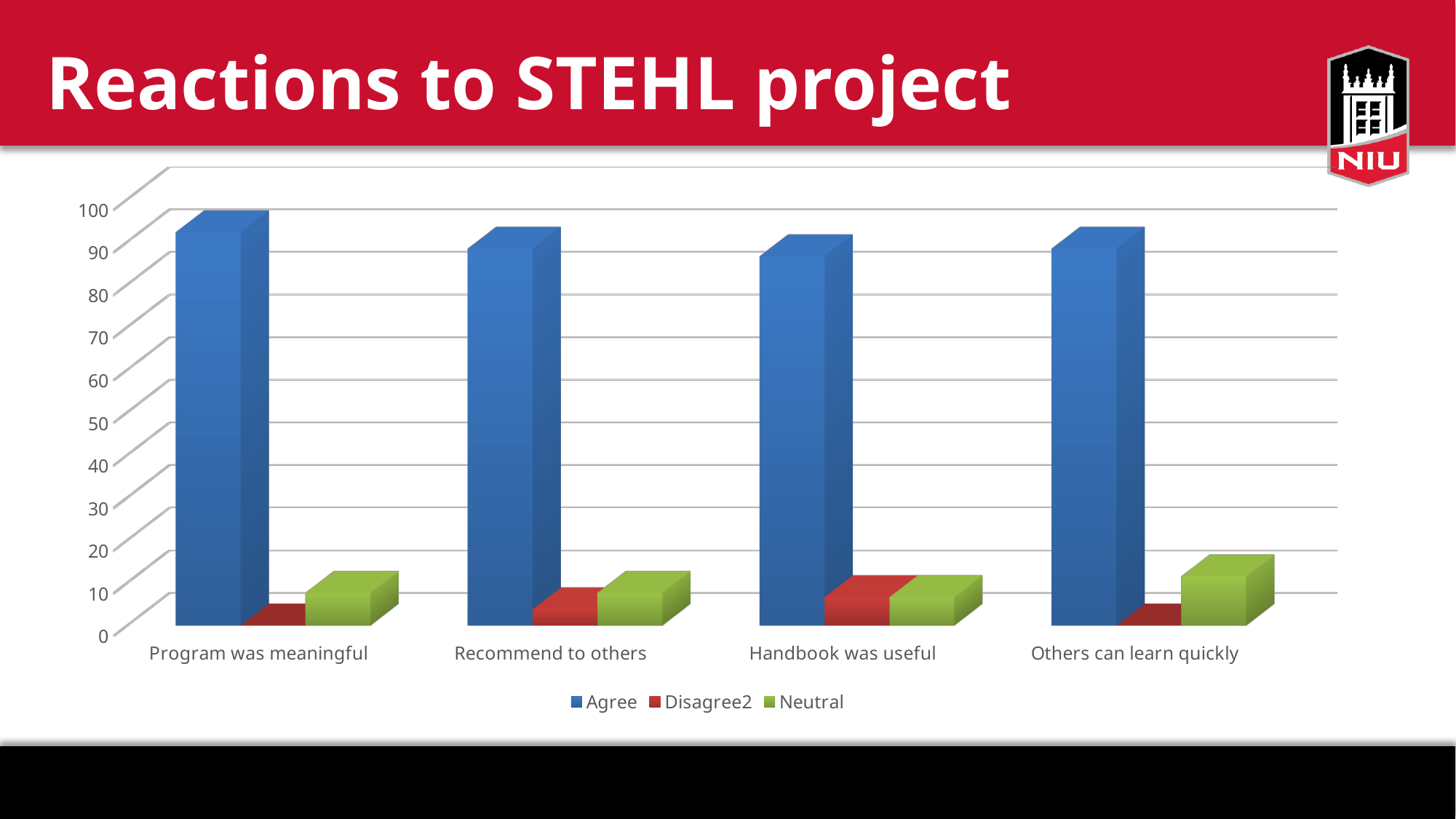
Is the Agree value for Handbook was useful greater or less than 80? greater Which category has the highest Disagree2 value? Handbook was useful Is the Neutral value for Others can learn quickly greater or less than 20? less Is the Disagree2 value for Handbook was useful greater or less than 20? less Which category has the highest Neutral value? Others can learn quickly For Recommend to others, which is larger: the Agree value or the Neutral value? Agree What kind of chart is shown on the slide? bar chart What is the title of the slide containing the chart? Reactions to STEHL project How many series does the legend list? 3 Which category has the highest Agree value? Program was meaningful How many categories are shown on the x axis of the chart? 4